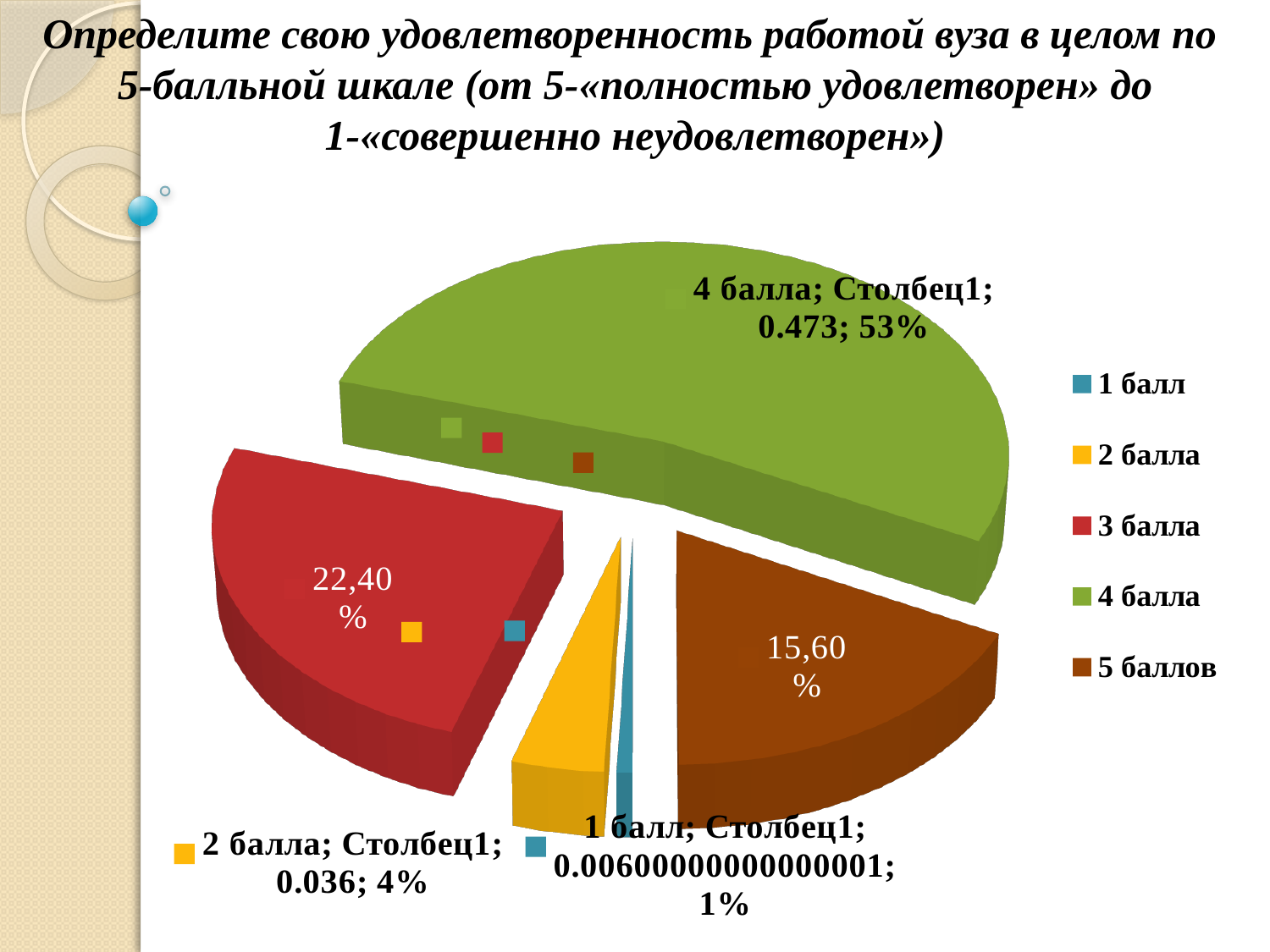
What percentage share is shown for the "1 балл" slice? 1% Which category has the smallest slice of the pie? 1 балл What percentage share is shown for the "5 баллов" slice? 15,60% What kind of chart is shown on the slide? pie chart What percentage share is shown for the "4 балла" slice? 53% How many entries does the legend list? 5 Which category has the largest slice of the pie? 4 балла What colour is the "4 балла" slice in the pie chart? green How many slices does the pie chart have? 5 Which slice is larger, "3 балла" or "5 баллов"? 3 балла